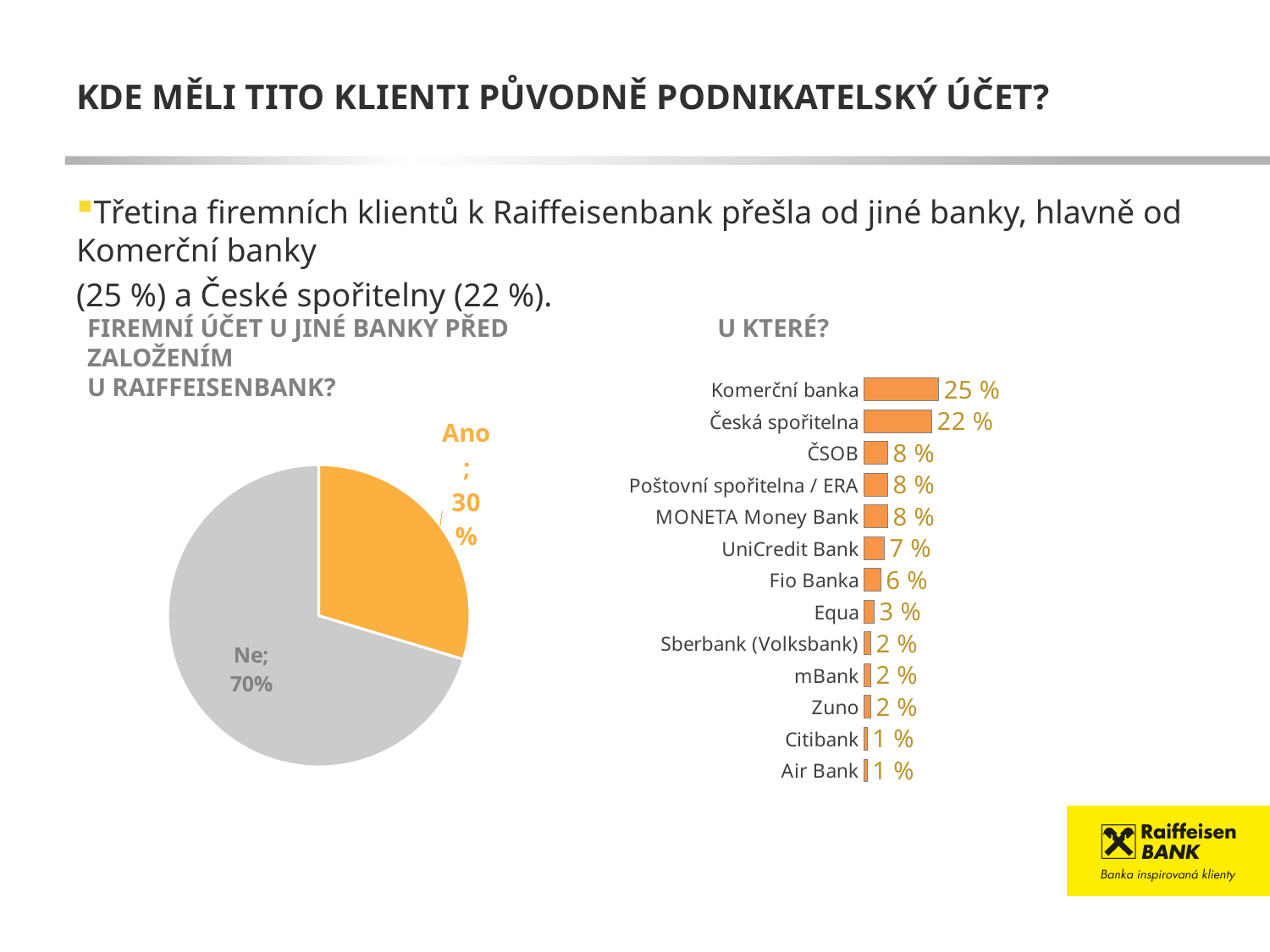
In the 'U KTERÉ?' chart, which is larger, UniCredit Bank or Fio Banka? UniCredit Bank In the 'U KTERÉ?' chart, what is the value for Komerční banka? 25 % In the 'U KTERÉ?' chart, how many banks are listed? 13 In the 'U KTERÉ?' chart, what is the value for Equa? 3 % In the 'U KTERÉ?' chart, which bank has the highest value? Komerční banka In the pie chart on the left, what is the value for 'Ne'? 70% In the 'U KTERÉ?' chart, what is the value for Česká spořitelna? 22 % What kind of chart is the chart on the left of the slide? Pie chart What kind of chart is the 'U KTERÉ?' chart on the right? Bar chart In the 'U KTERÉ?' chart, what is the difference between Komerční banka and Česká spořitelna? 3 % In the pie chart on the left, what share of the pie is the 'Ano' slice? 30 % In the pie chart on the left, how many slices are there? 2